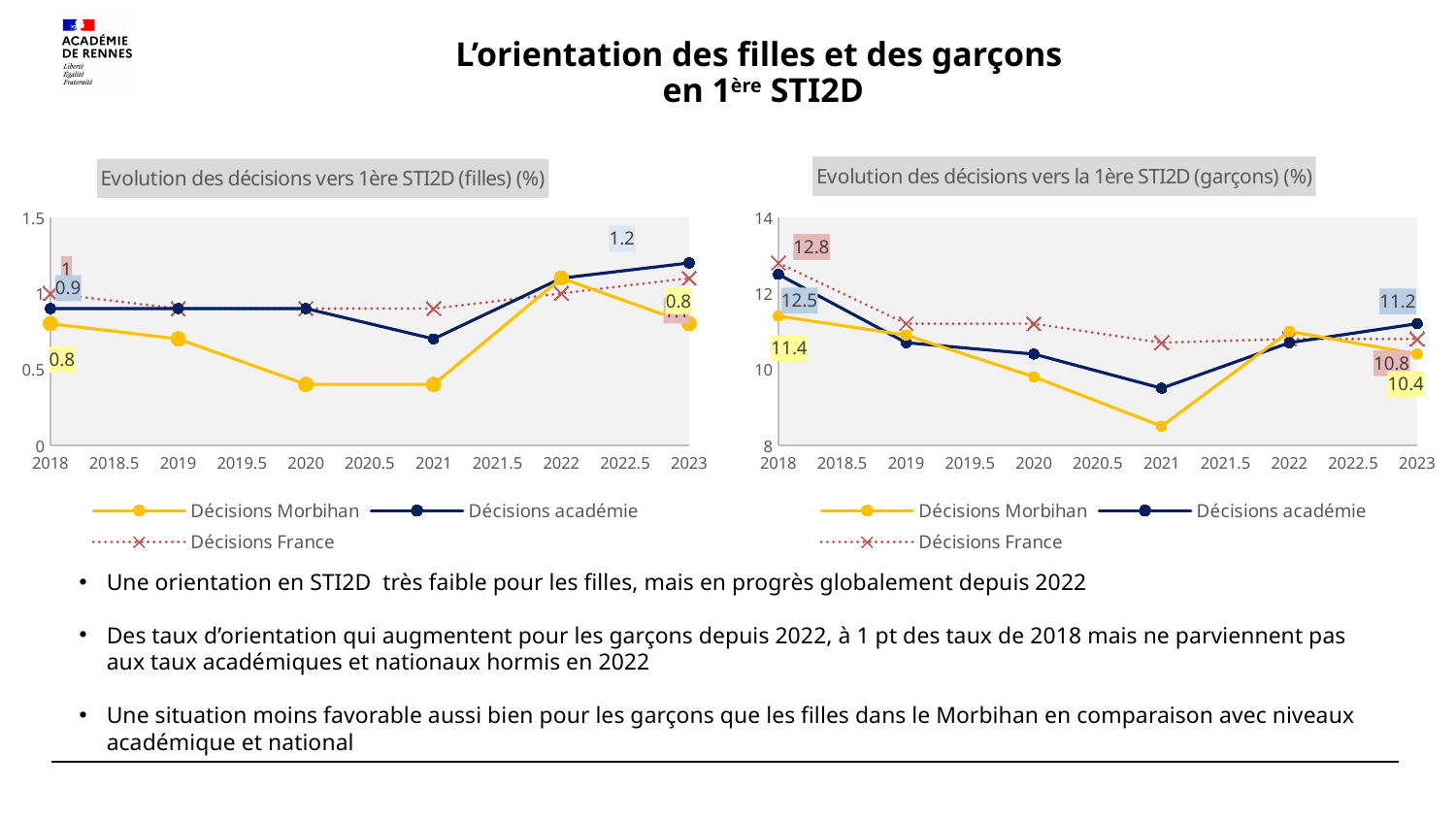
On the left chart (filles), what is the value of Décisions Morbihan in 2018? 0.8 On the right chart (garçons), in which year is Décisions Morbihan at its lowest? 2021 On the right chart (garçons), what is the value of Décisions France in 2018? 12.8 What type of chart is used on the left chart, 'Evolution des décisions vers 1ère STI2D (filles) (%)'? Line chart On the right chart (garçons), does Décisions académie rise or fall from 2018 to 2021? Fall How many series does the legend of the right chart, 'Evolution des décisions vers la 1ère STI2D (garçons) (%)', list? 3 On the right chart (garçons), what is the value of Décisions Morbihan in 2023? 10.4 On the right chart (garçons), what is the difference between Décisions France and Décisions Morbihan in 2018? 1.4 How many years are plotted on the left chart (filles)? 6 On the right chart (garçons), which is larger in 2018: Décisions académie or Décisions Morbihan? Décisions académie On the left chart (filles), is the value for Décisions Morbihan in 2020 greater or less than 0.5? less On the left chart (filles), what is the value of Décisions académie in 2023? 1.2